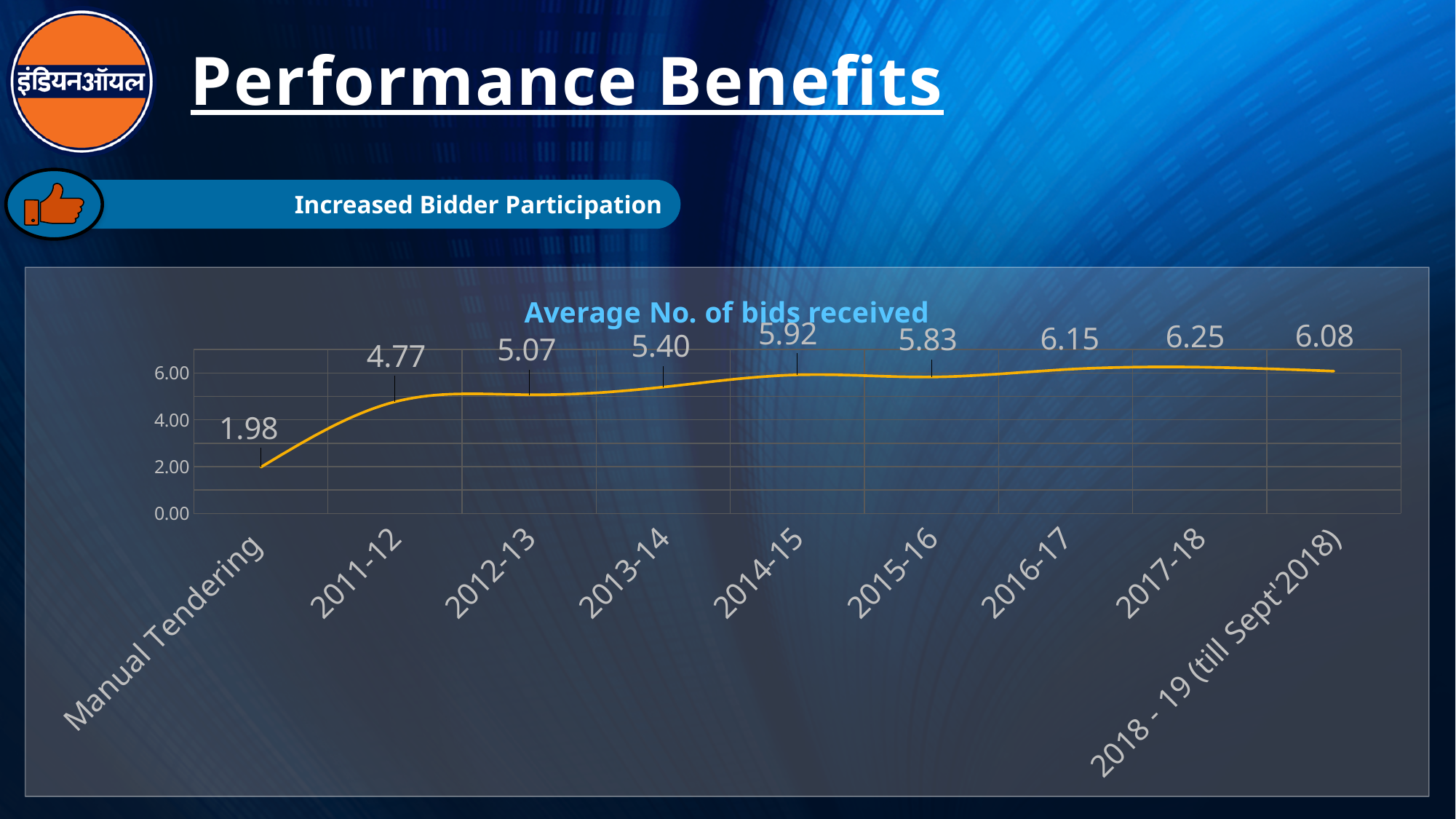
What is the average number of bids received for Manual Tendering? 1.98 Which category has the lowest average number of bids received? Manual Tendering Is the average number of bids received in 2013-14 greater or less than 4.00? greater What is the average number of bids received in 2018 - 19 (till Sept'2018)? 6.08 What is the difference between the average number of bids received in 2017-18 and in Manual Tendering? 4.27 What is the average number of bids received in 2014-15? 5.92 Does the average number of bids received rise or fall from Manual Tendering to 2014-15? rise How many categories are shown on the x axis of the chart? 9 What is the title of the chart? Average No. of bids received Which is larger, the average number of bids received in 2014-15 or in 2015-16? 2014-15 Which category has the highest average number of bids received? 2017-18 What kind of chart is shown on the slide? line chart